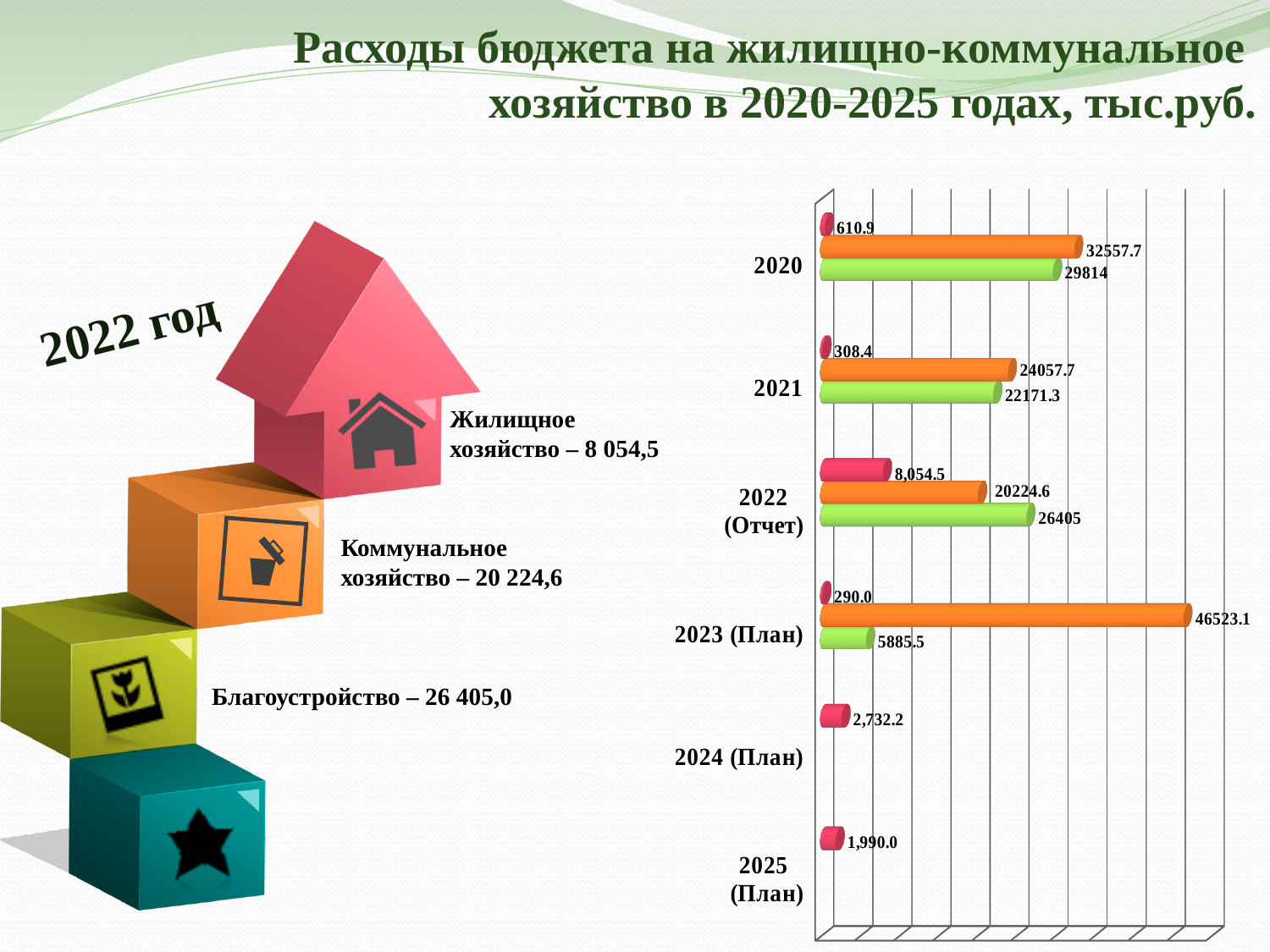
What is the value of the orange bar for 2020? 32557.7 What is the value of the pink bar for 2025 (План)? 1,990.0 How many categories are shown on the chart's vertical axis? 6 What is the value of the green bar for 2022 (Отчет)? 26405 What kind of chart is shown on the slide? bar chart Which category has the longest orange bar? 2023 (План) What is the value of the green bar for 2023 (План)? 5885.5 What is the value of the pink bar for 2024 (План)? 2,732.2 For 2022 (Отчет), which is larger: the orange bar or the green bar? the green bar What is the difference between the orange and green bar values for 2021? 1886.4 What is the difference between the orange and green bar values for 2020? 2743.7 Which category has the smallest pink bar value? 2023 (План)